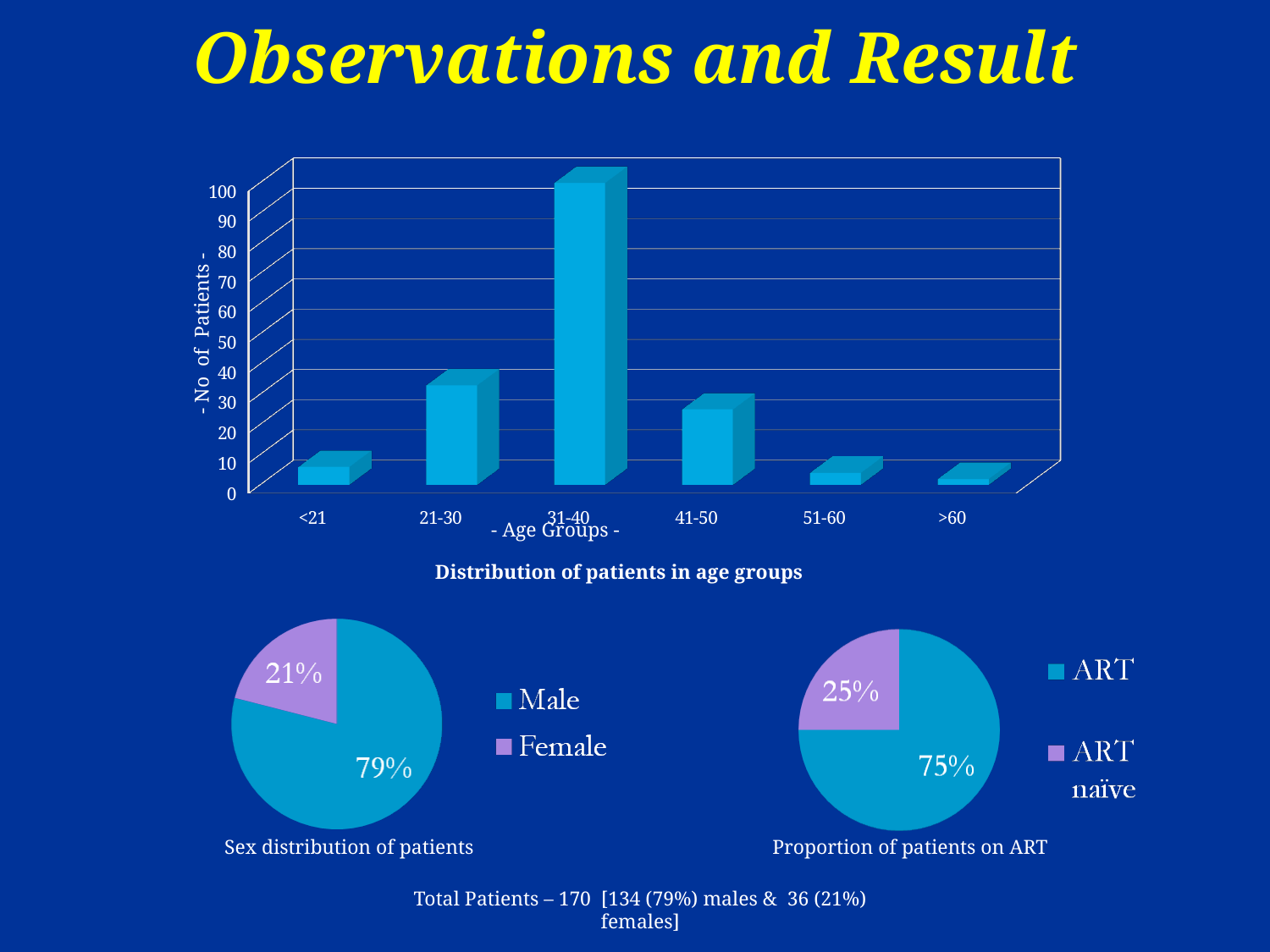
In the 'Sex distribution of patients' pie chart, what is the difference between the Male and Female shares? 58% In the 'Proportion of patients on ART' pie chart, what share of patients is ART naïve? 25% In the 'Distribution of patients in age groups' chart, which has more patients, the 21-30 age group or the 41-50 age group? 21-30 In the 'Distribution of patients in age groups' chart, is the value for the <21 age group greater or less than 10? less In the 'Distribution of patients in age groups' chart, which age group has the highest number of patients? 31-40 In the 'Sex distribution of patients' pie chart, what share of patients is Female? 21% In the 'Distribution of patients in age groups' chart, how many age groups are shown on the x axis? 6 In the 'Sex distribution of patients' pie chart, what share of patients is Male? 79% In the 'Distribution of patients in age groups' chart, is the value for the 31-40 age group greater or less than 90? greater In the 'Distribution of patients in age groups' chart, is the value for the 21-30 age group greater or less than 40? less What kind of chart is 'Distribution of patients in age groups'? bar chart How many entries does the legend of the 'Proportion of patients on ART' pie chart list? 2